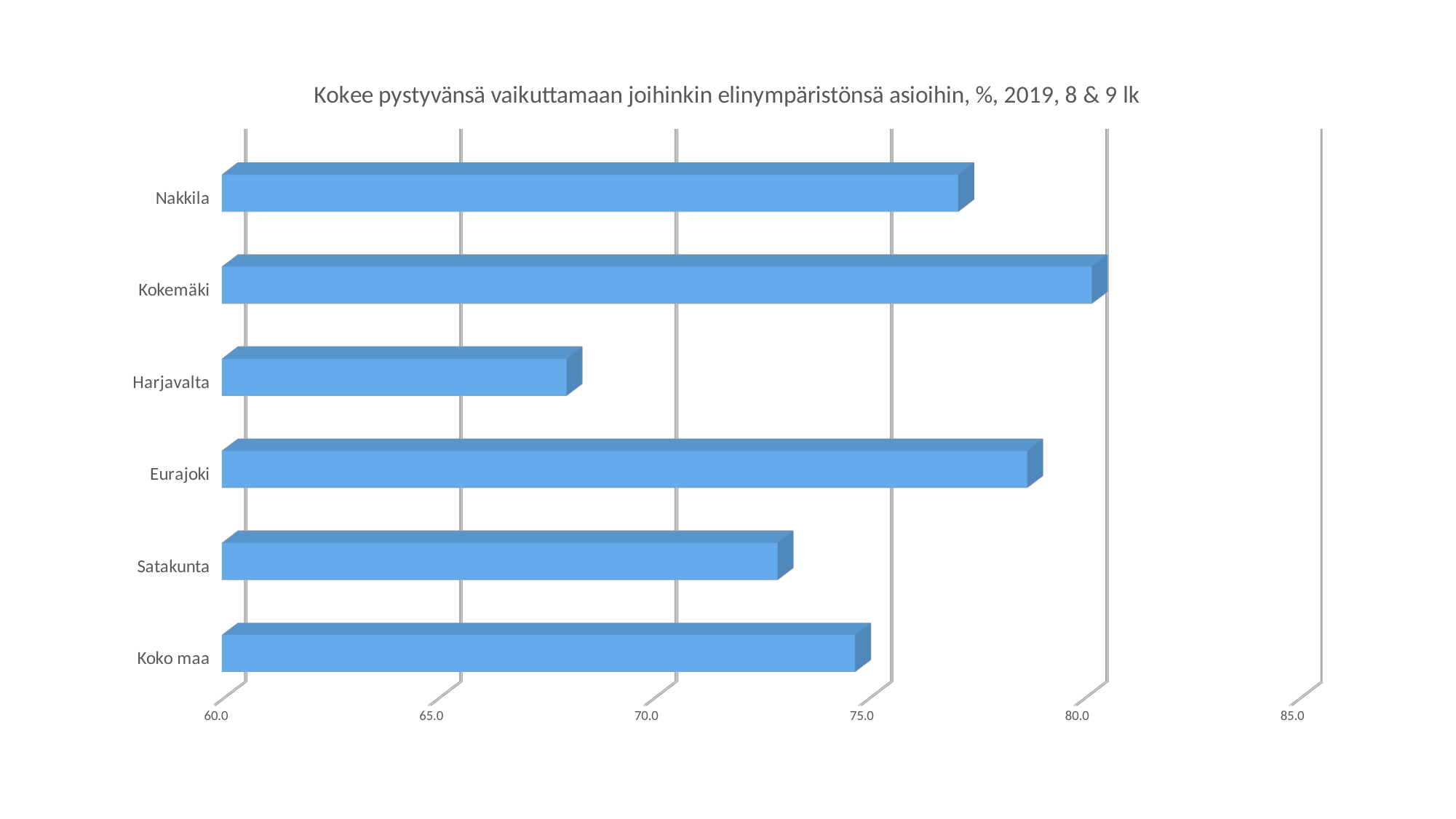
Is the value for Eurajoki greater or less than 75.0? greater Which is larger, the value for Eurajoki or the value for Koko maa? Eurajoki Which is larger, the value for Harjavalta or the value for Satakunta? Satakunta Which is larger, the value for Nakkila or the value for Satakunta? Nakkila Which category has the highest value in the chart? Kokemäki Is the value for Nakkila greater or less than 75.0? greater How many categories are plotted in the chart? 6 Which category has the lowest value in the chart? Harjavalta Is the value for Satakunta greater or less than 75.0? less What is the title of the chart? Kokee pystyvänsä vaikuttamaan joihinkin elinympäristönsä asioihin, %, 2019, 8 & 9 lk What kind of chart is shown on the slide? Bar chart